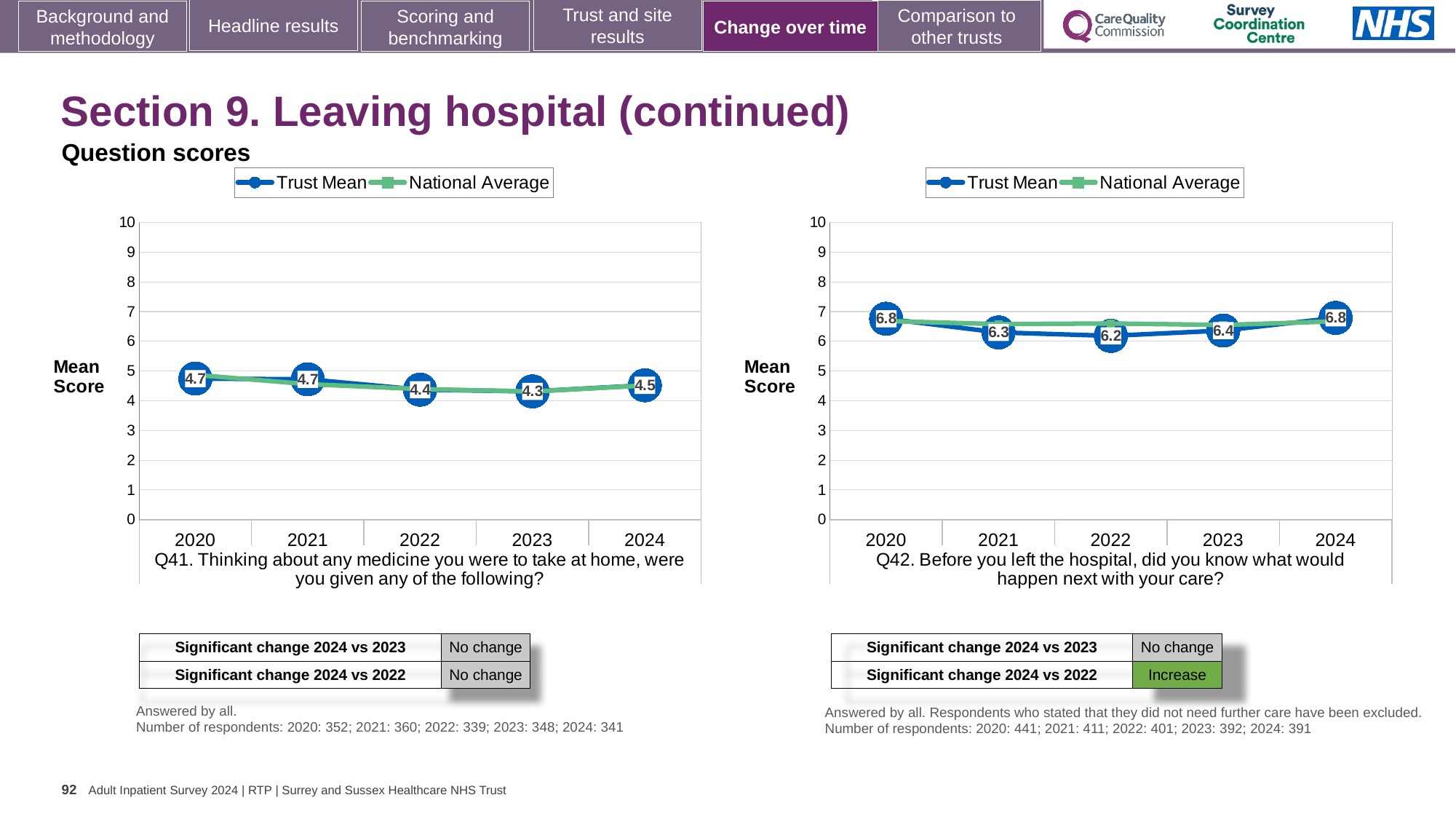
In the Q41 chart, what is the Trust Mean score for 2023? 4.3 How many series does the legend of the Q42 chart list? 2 In the Q42 chart, is the National Average for 2020 greater or less than 6? greater What kind of chart is used for Q42? Line chart In the Q42 chart, what is the difference between the Trust Mean scores for 2020 and 2022? 0.6 In the Q41 chart, is the National Average for 2024 greater or less than 5? less In the Q42 chart, which year has the lowest Trust Mean score? 2022 In the Q41 chart, what is the difference between the Trust Mean scores for 2020 and 2023? 0.4 In the Q42 chart, is the Trust Mean score higher in 2023 or in 2021? 2023 In the Q42 chart, what is the Trust Mean score for 2021? 6.3 In the Q41 chart, which year has the lowest Trust Mean score? 2023 How many years are plotted on the x axis of the Q41 chart? 5